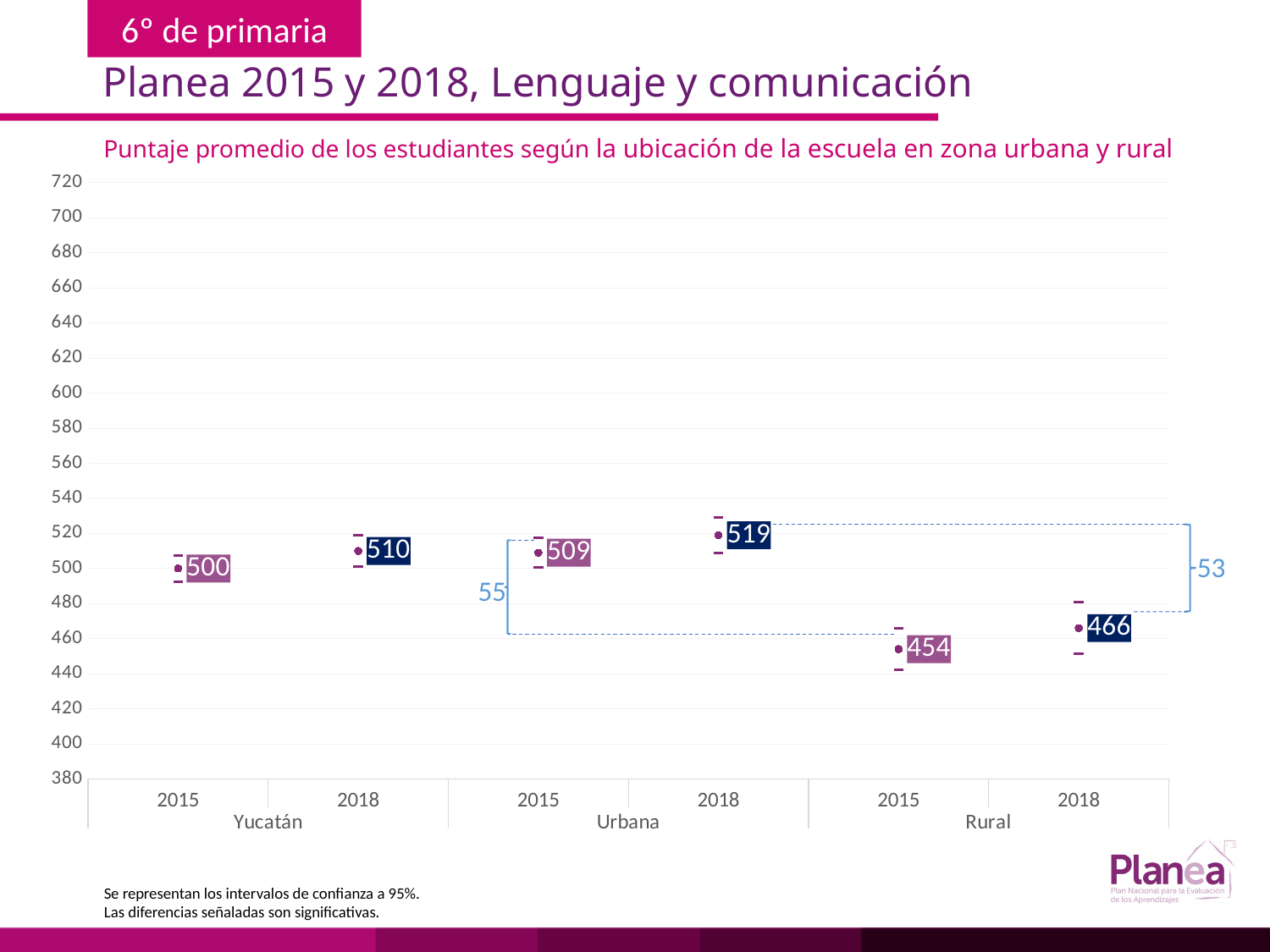
What is the average score for Yucatán in 2015? 500 Which group and year has the highest average score? Urbana 2018 Is the Rural 2015 score greater or less than 460? less What is the average score for Rural in 2018? 466 How many data points are plotted on the chart? 6 What is the average score for Rural in 2015? 454 Which is larger, the Urbana 2018 score or the Rural 2018 score? Urbana 2018 What is the average score for Urbana in 2018? 519 What is the difference between the Urbana and Rural scores in 2018? 53 By how much did the Yucatán score change from 2015 to 2018? 10 What is the difference between the Urbana and Rural scores in 2015? 55 Which group and year has the lowest average score? Rural 2015